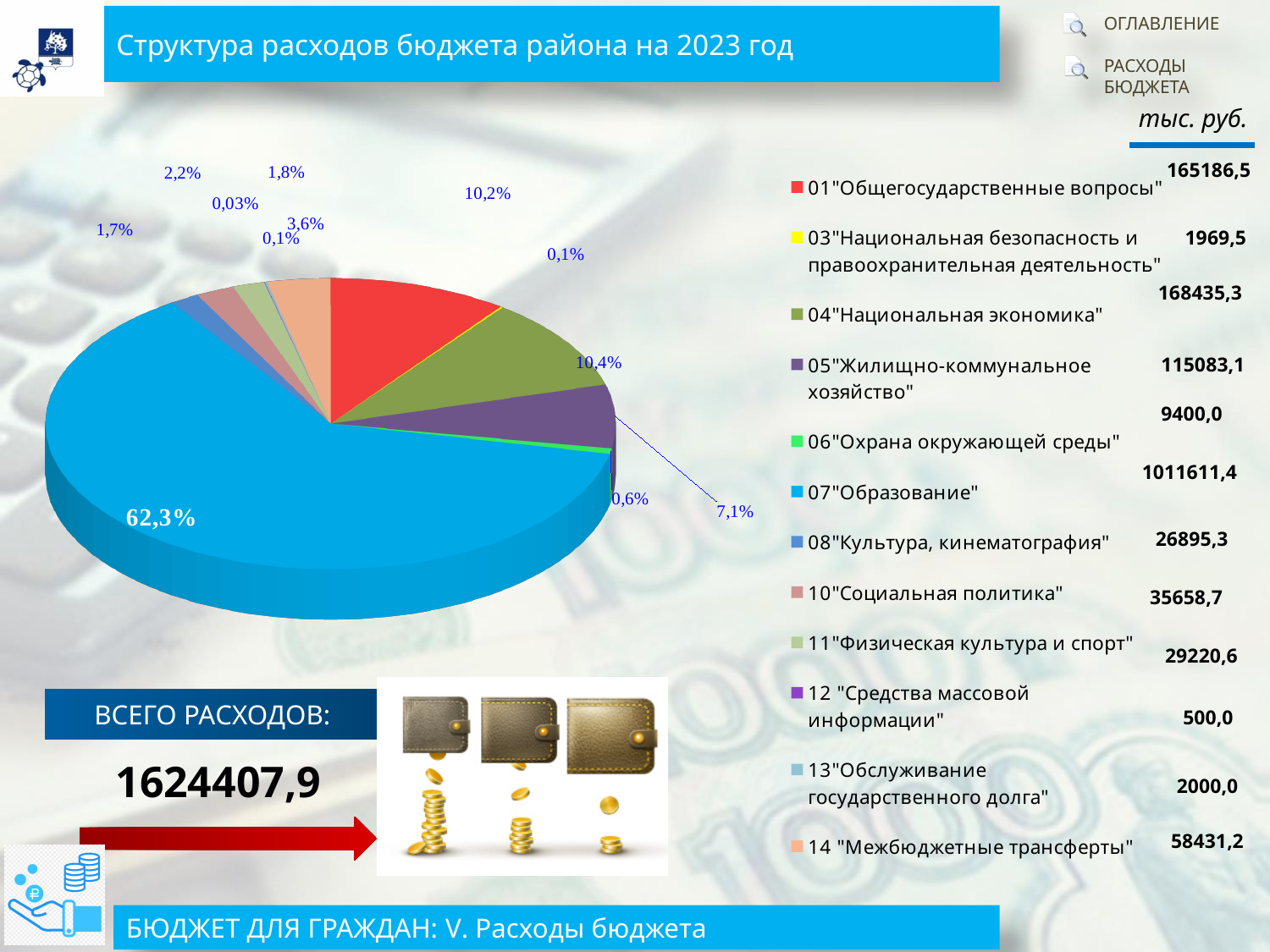
How many categories does the legend of the pie chart list? 12 What is the difference between the values for 04"Национальная экономика" and 01"Общегосударственные вопросы"? 3248,8 What total expenditure (ВСЕГО РАСХОДОВ) is shown on the slide? 1624407,9 What share of the pie does 07"Образование" take, according to the label on the chart? 62,3% What is the value shown for 04"Национальная экономика"? 168435,3 What is the value shown for 13"Обслуживание государственного долга"? 2000,0 Which category has the largest value in the pie chart? 07"Образование" What unit is stated for the values in the legend? тыс. руб. Which is larger: the value for 10"Социальная политика" or for 11"Физическая культура и спорт"? 10"Социальная политика" What kind of chart is shown on the slide? pie chart Which category has the smallest value in the pie chart? 12 "Средства массовой информации" What is the value shown for 07"Образование"? 1011611,4